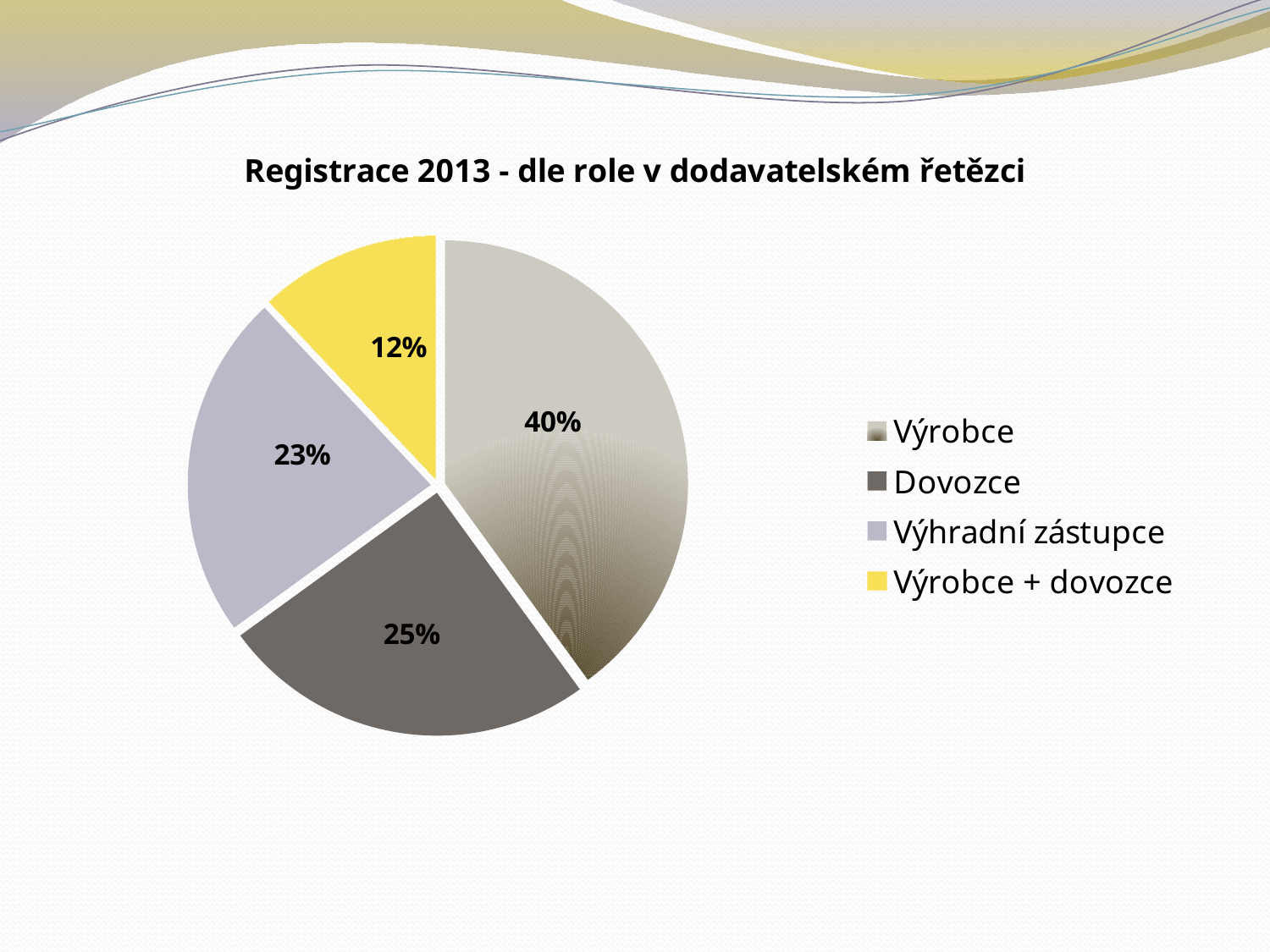
What kind of chart is shown on the slide? Pie chart What share of the pie does Dovozce have? 25% What is the title of the chart? Registrace 2013 - dle role v dodavatelském řetězci Which category has the largest slice of the pie? Výrobce What share of the pie does Výrobce have? 40% What share of the pie does Výrobce + dovozce have? 12% What is the difference in percentage points between Výrobce and Dovozce? 15 Which is larger, the share for Dovozce or the share for Výhradní zástupce? Dovozce Which category has the smallest slice of the pie? Výrobce + dovozce What is the difference in percentage points between Výhradní zástupce and Výrobce + dovozce? 11 How many categories does the pie chart show? 4